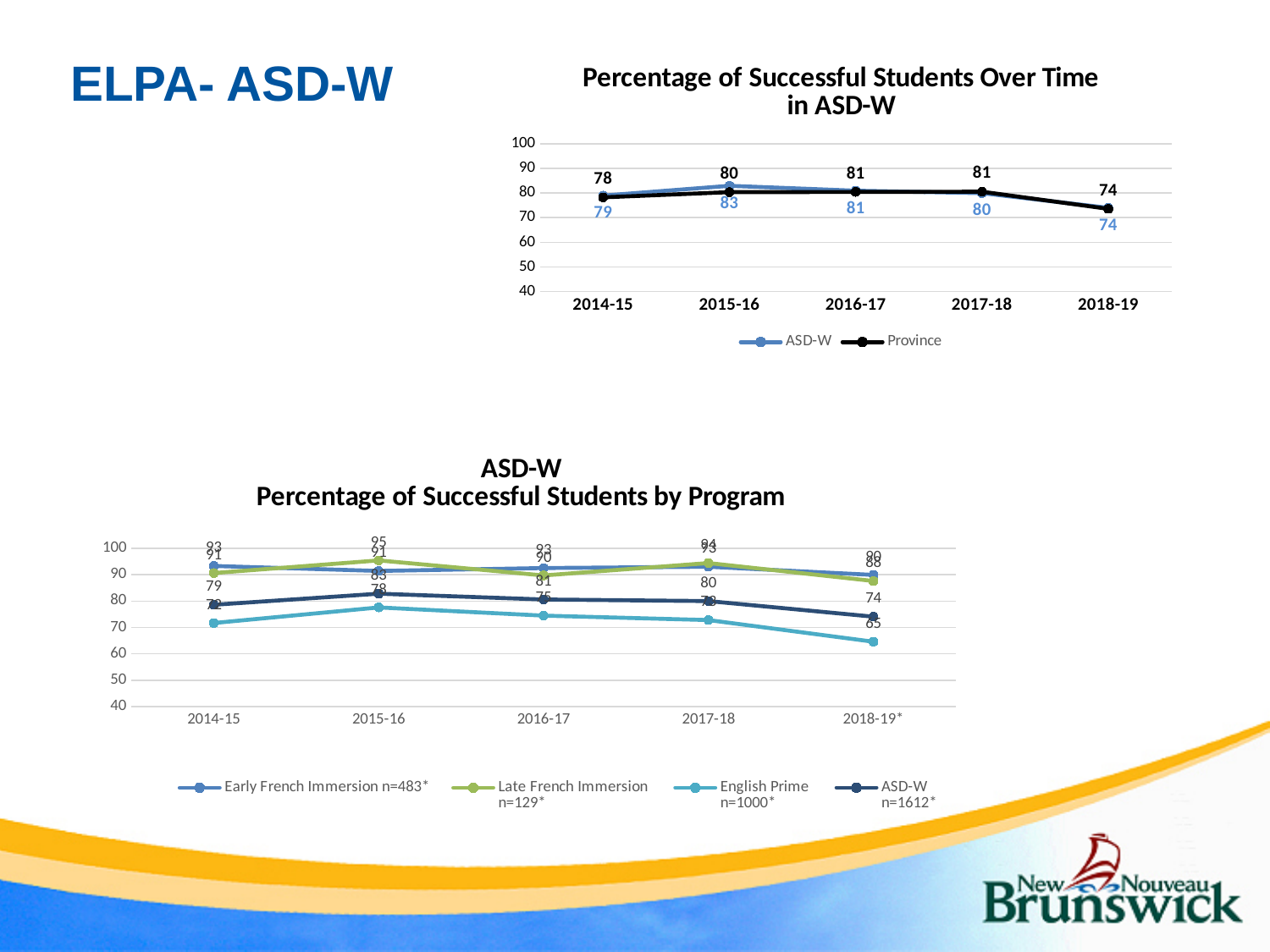
In the chart 'ASD-W Percentage of Successful Students by Program', which program has the lowest value in 2018-19*? English Prime In the chart 'Percentage of Successful Students Over Time in ASD-W', what is the ASD-W value for 2018-19? 74 In the chart 'Percentage of Successful Students Over Time in ASD-W', what is the difference between the ASD-W and Province values in 2015-16? 3 In the chart 'Percentage of Successful Students Over Time in ASD-W', what is the Province value for 2014-15? 78 In the chart 'ASD-W Percentage of Successful Students by Program', how many series does the legend list? 4 What kind of chart is 'ASD-W Percentage of Successful Students by Program'? line chart In the chart 'Percentage of Successful Students Over Time in ASD-W', how many series does the legend list? 2 In the chart 'ASD-W Percentage of Successful Students by Program', what is the English Prime value for 2018-19*? 65 In the chart 'Percentage of Successful Students Over Time in ASD-W', do the Province values rise or fall from 2017-18 to 2018-19? fall In the chart 'Percentage of Successful Students Over Time in ASD-W', which is larger in 2014-15, ASD-W or Province? ASD-W In the chart 'Percentage of Successful Students Over Time in ASD-W', in which year is the ASD-W value highest? 2015-16 In the chart 'Percentage of Successful Students Over Time in ASD-W', what is the ASD-W value for 2015-16? 83